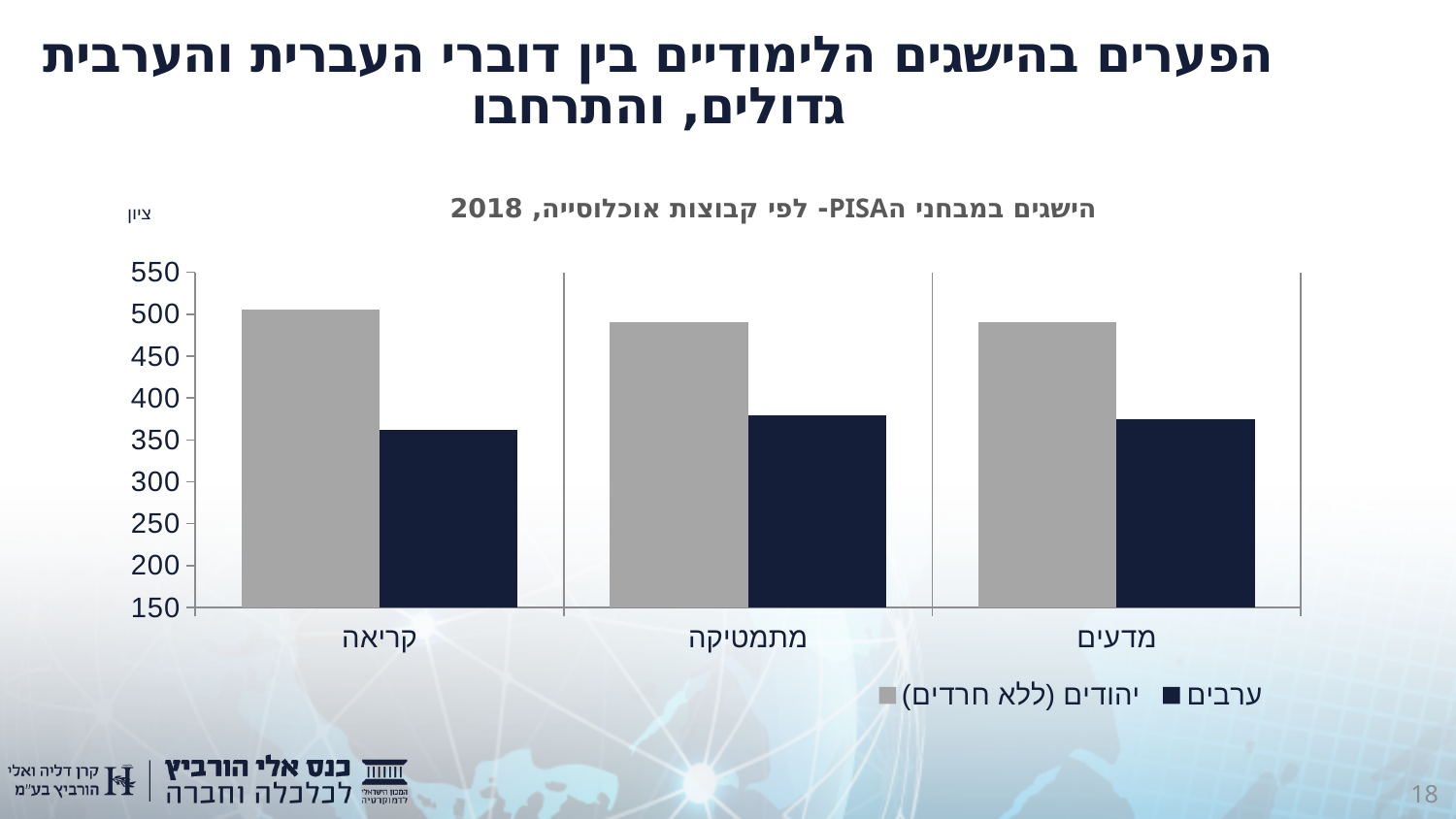
In the category קריאה, which series has the larger value, יהודים (ללא חרדים) or ערבים? יהודים (ללא חרדים) Is the value for יהודים (ללא חרדים) in קריאה greater or less than 450? greater What kind of chart is shown on the slide? bar chart How many series does the chart's legend list? 2 Which category has the lowest value for the series ערבים? קריאה Is the value for ערבים in קריאה greater or less than 400? less Is the value for יהודים (ללא חרדים) in מדעים greater or less than 500? less Which series is shown in dark navy bars? ערבים Which category has the highest value for the series יהודים (ללא חרדים)? קריאה What is the title of the chart? הישגים במבחני הPISA- לפי קבוצות אוכלוסייה, 2018 How many categories are shown on the x axis of the chart? 3